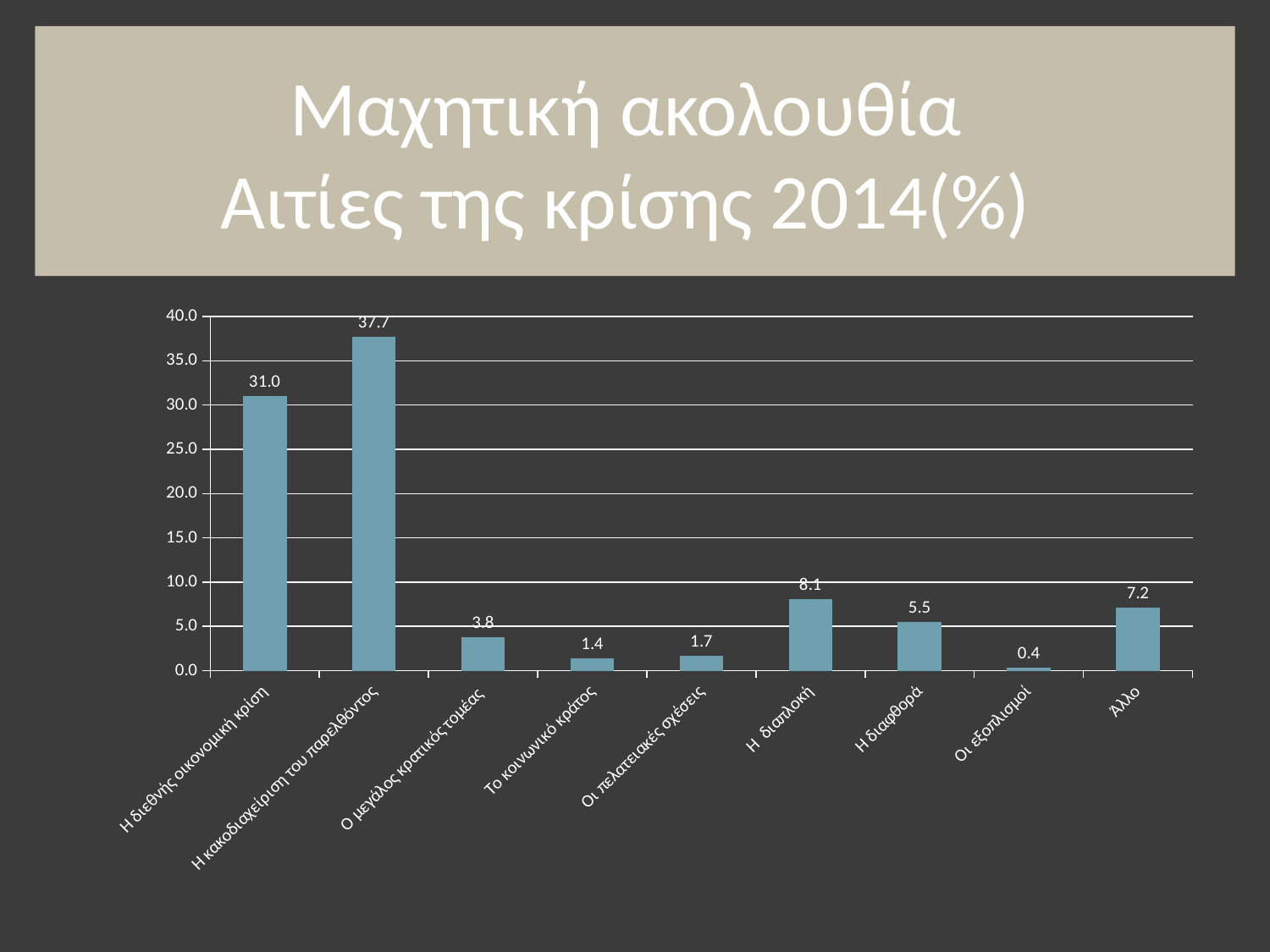
What is the value for Η κακοδιαχείριση του παρελθόντος? 37.7 Which category has the highest value? Η κακοδιαχείριση του παρελθόντος What is the value for Η διεθνής οικονομική κρίση? 31.0 Which category has the lowest value? Οι εξοπλισμοί How many categories are shown on the x axis? 9 What kind of chart is shown on the slide? bar chart What is the difference between the values for Η κακοδιαχείριση του παρελθόντος and Η διεθνής οικονομική κρίση? 6.7 Is the value for Η διαπλοκή greater or less than 10.0? less What is the value for Οι εξοπλισμοί? 0.4 What is the title of the slide? Μαχητική ακολουθία Αιτίες της κρίσης 2014(%) Which is larger, the value for Η διαφθορά or the value for Άλλο? Άλλο What is the value for Η διαπλοκή? 8.1